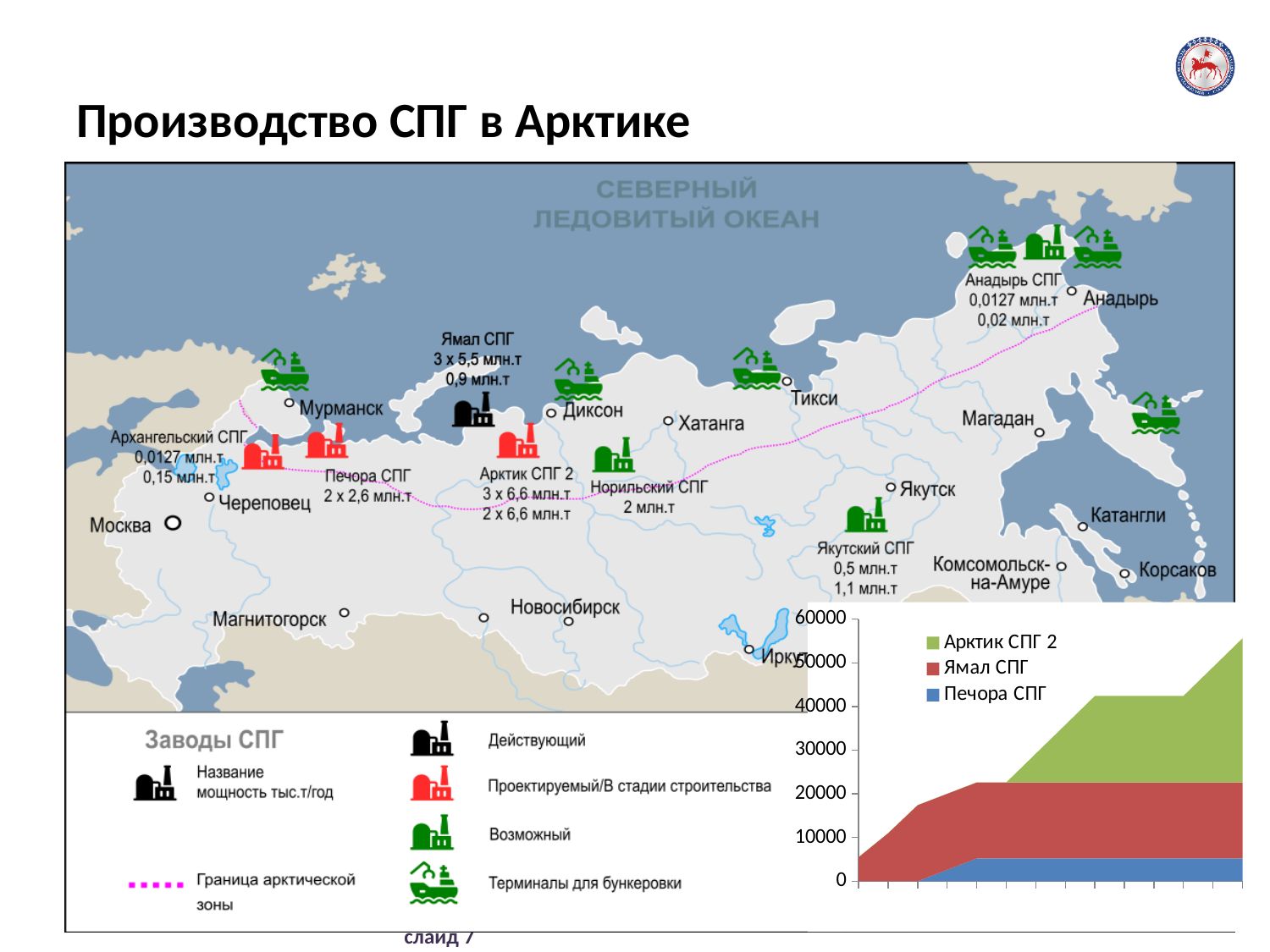
Which series contributes the largest amount at the right end of the chart? Арктик СПГ 2 Which series contributes the smallest amount at the right end of the chart? Печора СПГ Is the total stacked value at the right end of the chart greater or less than 50000? greater At the right end of the chart, which is larger: the Арктик СПГ 2 area or the Печора СПГ area? Арктик СПГ 2 How many series does the legend of the chart list? 3 Is the value for Печора СПГ at the right end of the chart greater or less than 10000? less Do the total stacked values in the chart rise or fall along the x axis? rise What kind of chart is shown in the bottom right of the slide? stacked area chart What colour represents Арктик СПГ 2 in the chart? green What is the highest value shown on the chart's y axis? 60000 Is the cumulative top of the Ямал СПГ area at the right end of the chart greater or less than 30000? less Which series are listed in the chart legend? Арктик СПГ 2, Ямал СПГ, Печора СПГ